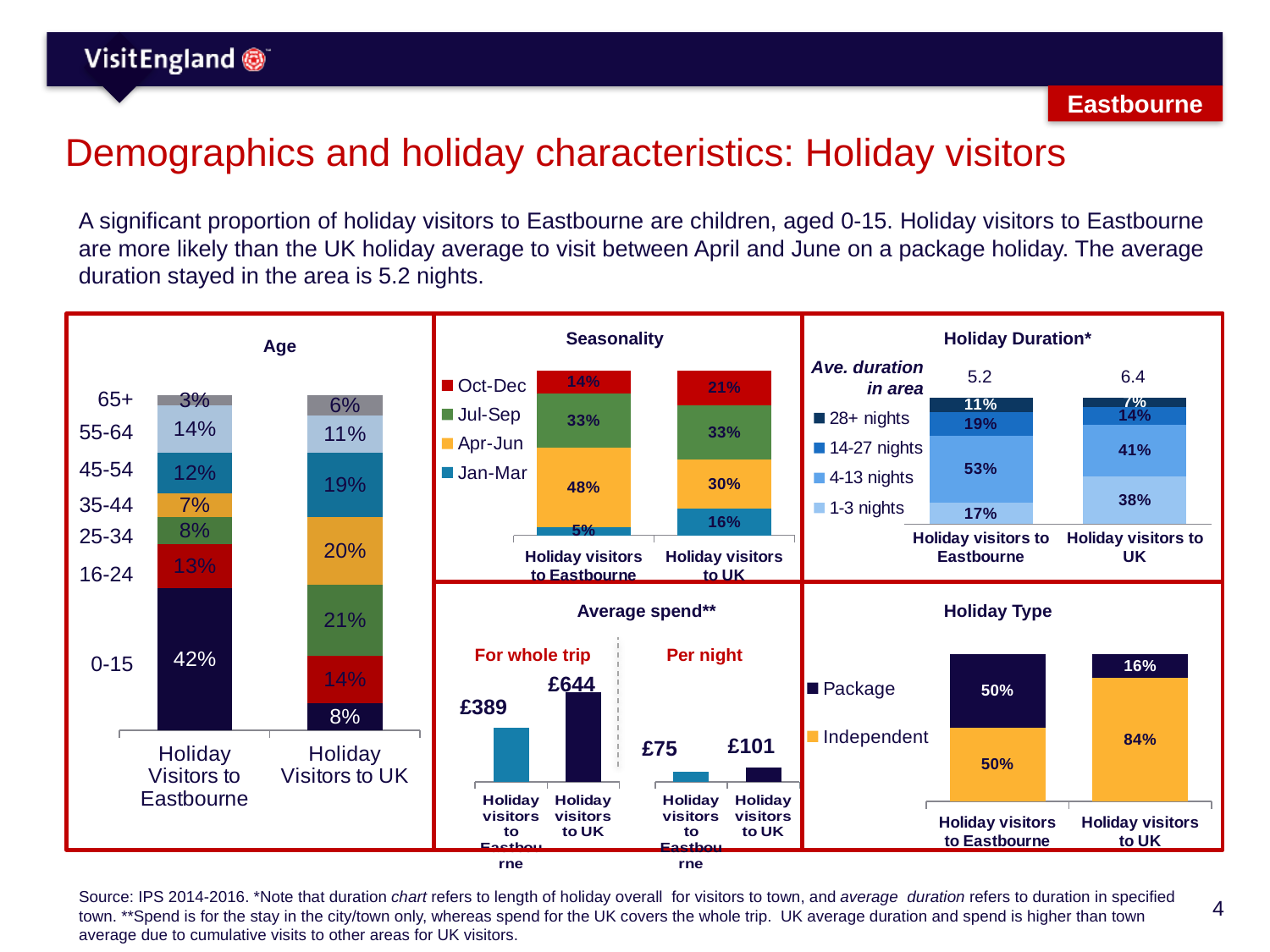
In the Seasonality chart, how many series does the legend list? 4 In the Holiday Duration chart, which duration band is the largest for holiday visitors to Eastbourne? 4-13 nights In the Seasonality chart, what percentage of holiday visitors to Eastbourne visit in Apr-Jun? 48% In the Holiday Duration chart, what is the average duration in area for holiday visitors to Eastbourne? 5.2 In the Age chart, what percentage of holiday visitors to Eastbourne are aged 0-15? 42% In the Average spend chart, what is the difference in per night spend between holiday visitors to the UK and holiday visitors to Eastbourne? £26 In the Seasonality chart, what is the difference between the Apr-Jun share for holiday visitors to Eastbourne and for holiday visitors to the UK? 18 percentage points In the Average spend chart, what is the spend for the whole trip for holiday visitors to the UK? £644 What kind of chart is the Average spend chart? Bar chart In the Age chart, which age group has the largest share among holiday visitors to the UK? 25-34 In the Holiday Type chart, what percentage of holiday visitors to the UK are on a package holiday? 16% In the Holiday Duration chart, what percentage of holiday visitors to the UK stay 1-3 nights? 38%